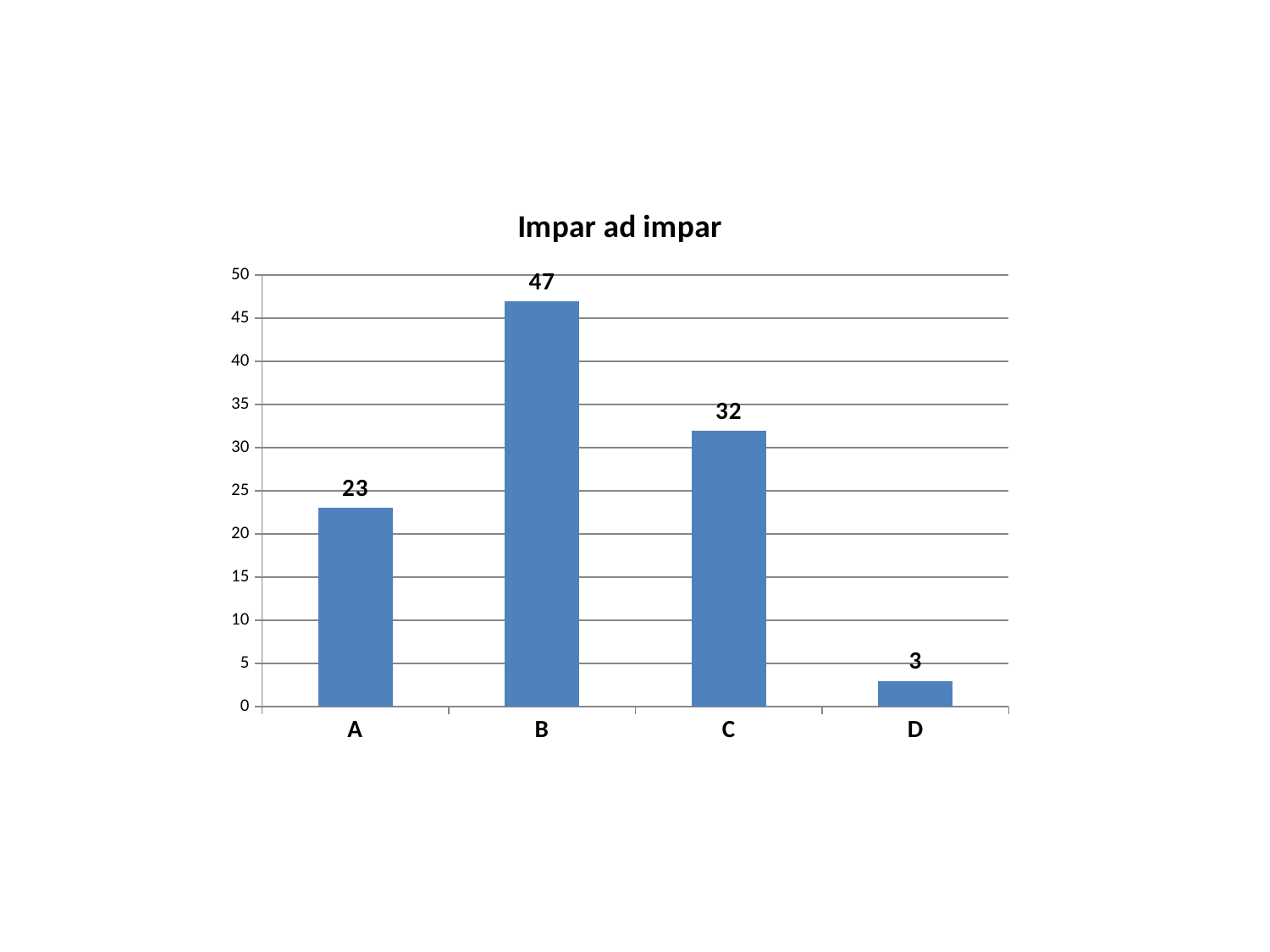
How many categories are shown on the x axis? 4 What is the value for category D? 3 What is the value for category A? 23 What is the title of the chart? Impar ad impar What is the difference between the values for B and C? 15 Which category has the highest value? B What is the value for category C? 32 Which is larger, the value for A or the value for C? C What is the difference between the values for A and D? 20 Is the value for B greater or less than 40? greater Which category has the lowest value? D What is the value for category B? 47